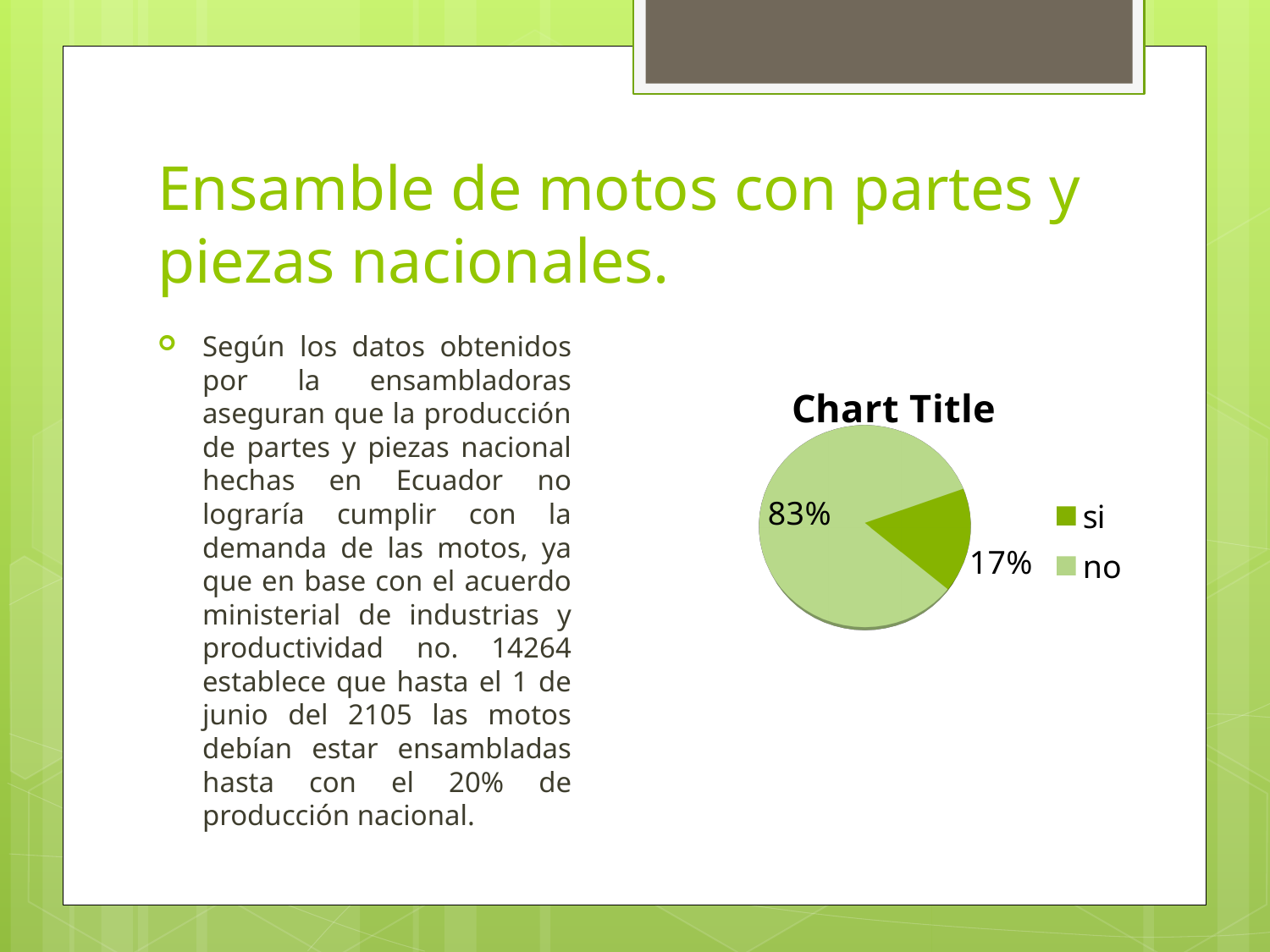
What percentage is shown for the "no" slice? 83% How many entries does the chart legend list? 2 How many slices does the pie chart have? 2 Which slice is the smallest in the pie chart? si Which slice is the largest in the pie chart? no What kind of chart is shown on the slide? pie chart What percentage is shown for the "si" slice? 17% What share of the pie does the "si" slice represent? 17% Which is larger, the "si" slice or the "no" slice? no What is the difference in percentage points between the "no" slice and the "si" slice? 66 What is the title of the chart? Chart Title Which legend entry is shown in the darker green colour? si